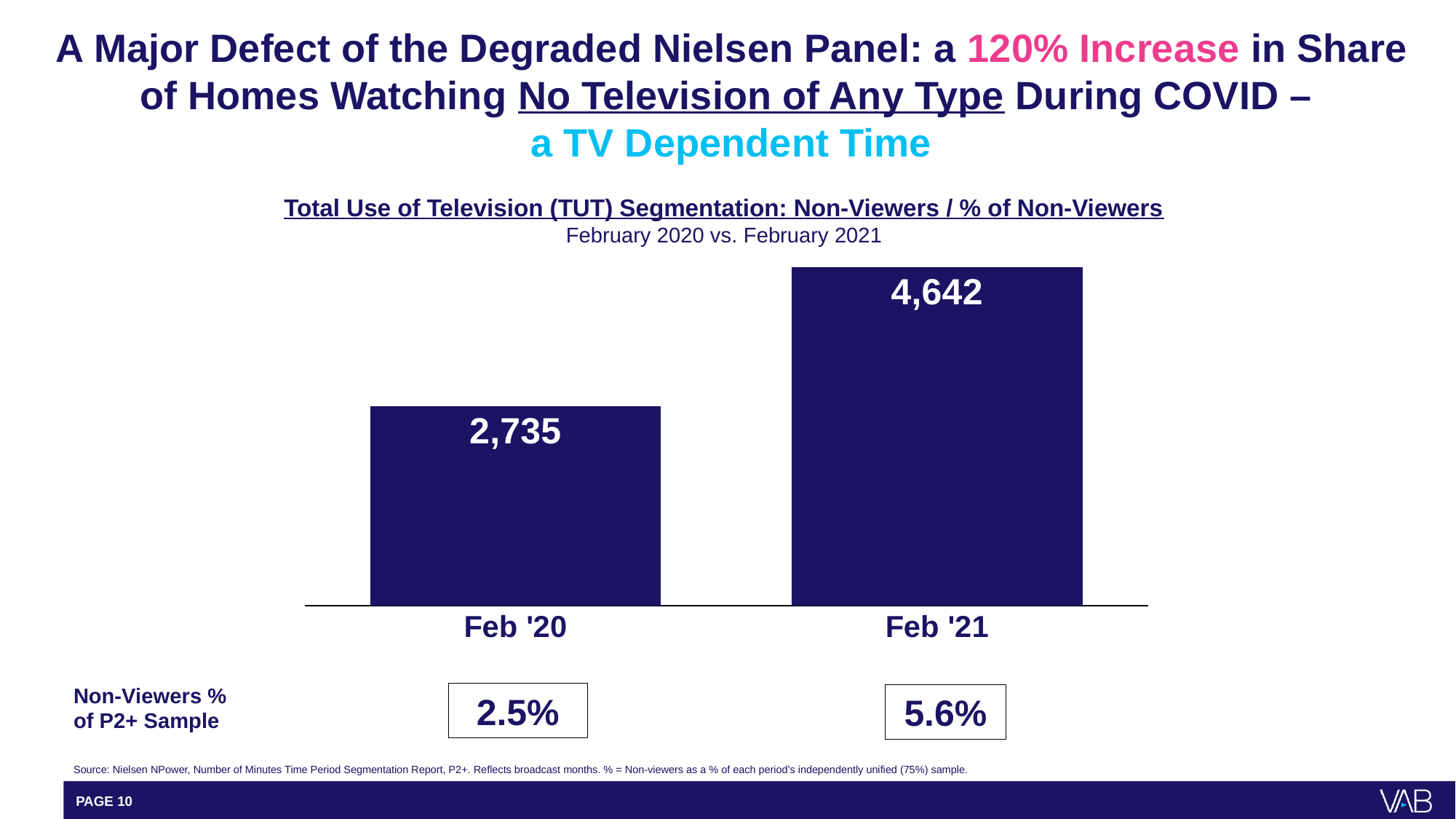
Which is larger, the value for Feb '20 or Feb '21? Feb '21 How many categories are shown in the chart? 2 What is the difference between the Feb '21 and Feb '20 values? 1,907 Do the values rise or fall from Feb '20 to Feb '21? Rise What is the Non-Viewers % of P2+ Sample shown for Feb '20? 2.5% What two periods does the chart subtitle say are compared? February 2020 vs. February 2021 What is the Non-Viewers % of P2+ Sample shown for Feb '21? 5.6% What is the value for Feb '21? 4,642 Which category has the lowest value? Feb '20 What is the value for Feb '20? 2,735 Which category has the highest value? Feb '21 What kind of chart is shown on the slide? Bar chart